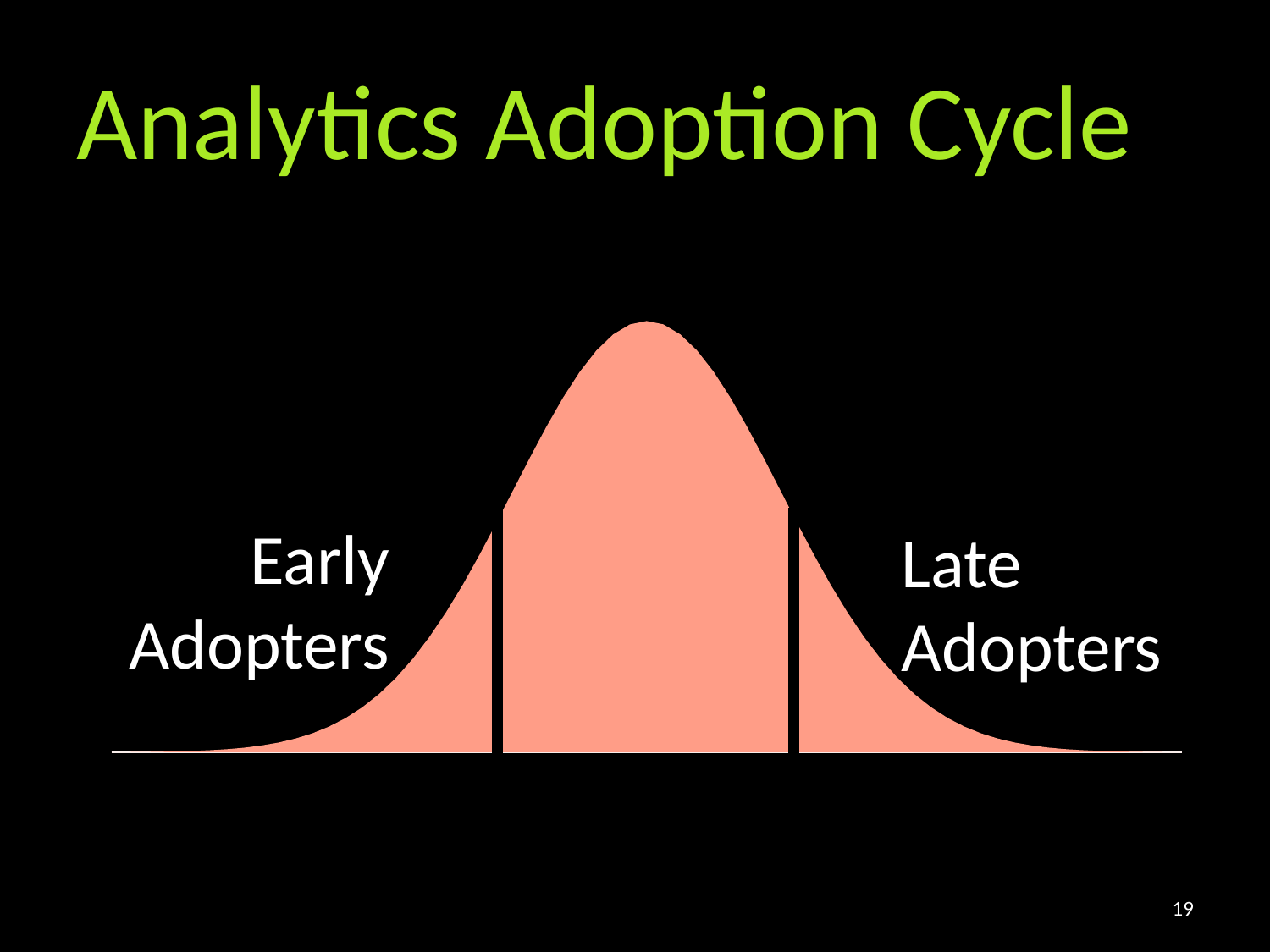
How many vertical divider lines split the curve into sections? 2 Does the curve rise or fall moving from the left edge toward the centre? rise What kind of chart is shown on the slide? bell curve What is the title of the chart on the slide? Analytics Adoption Cycle How many sections is the curve divided into by the vertical lines? 3 Which label appears on the left side of the curve? Early Adopters Does the curve rise or fall moving from the centre toward the right edge? fall